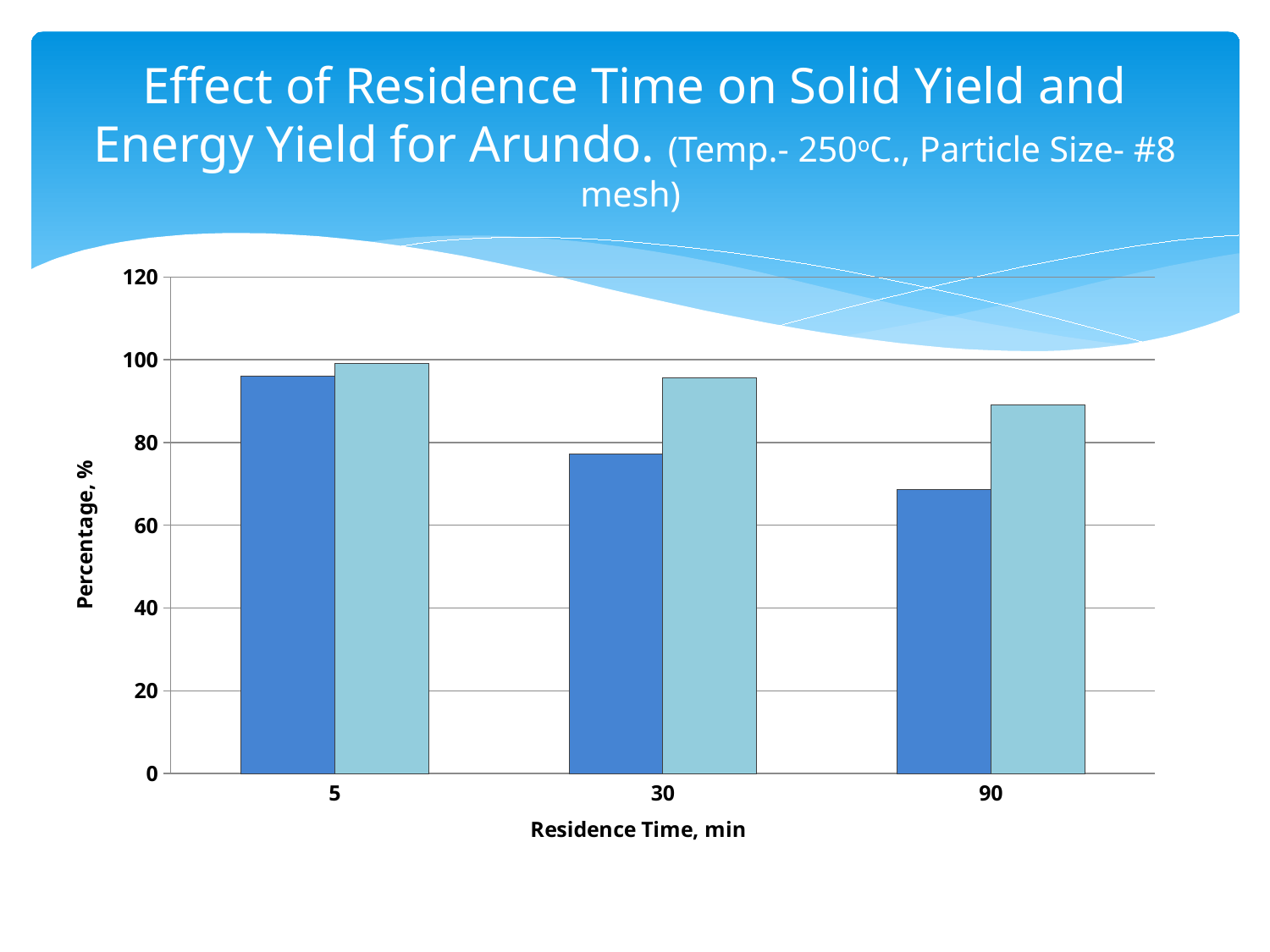
Is the value of the light blue bar at 90 min greater or less than 80? greater At which residence time is the dark blue bar highest? 5 What is the title of the y axis? Percentage, % At a residence time of 90 min, which bar is taller, the dark blue or the light blue? light blue Do the dark blue bars rise or fall as residence time increases from 5 to 90 min? fall At which residence time is the dark blue bar lowest? 90 Do the light blue bars rise or fall as residence time increases from 5 to 90 min? fall What kind of chart is shown on the slide? bar chart How many bars are plotted for each residence time category? 2 At which residence time is the light blue bar lowest? 90 Is the value of the dark blue bar at 30 min greater or less than 80? less How many residence time categories are shown on the x axis? 3